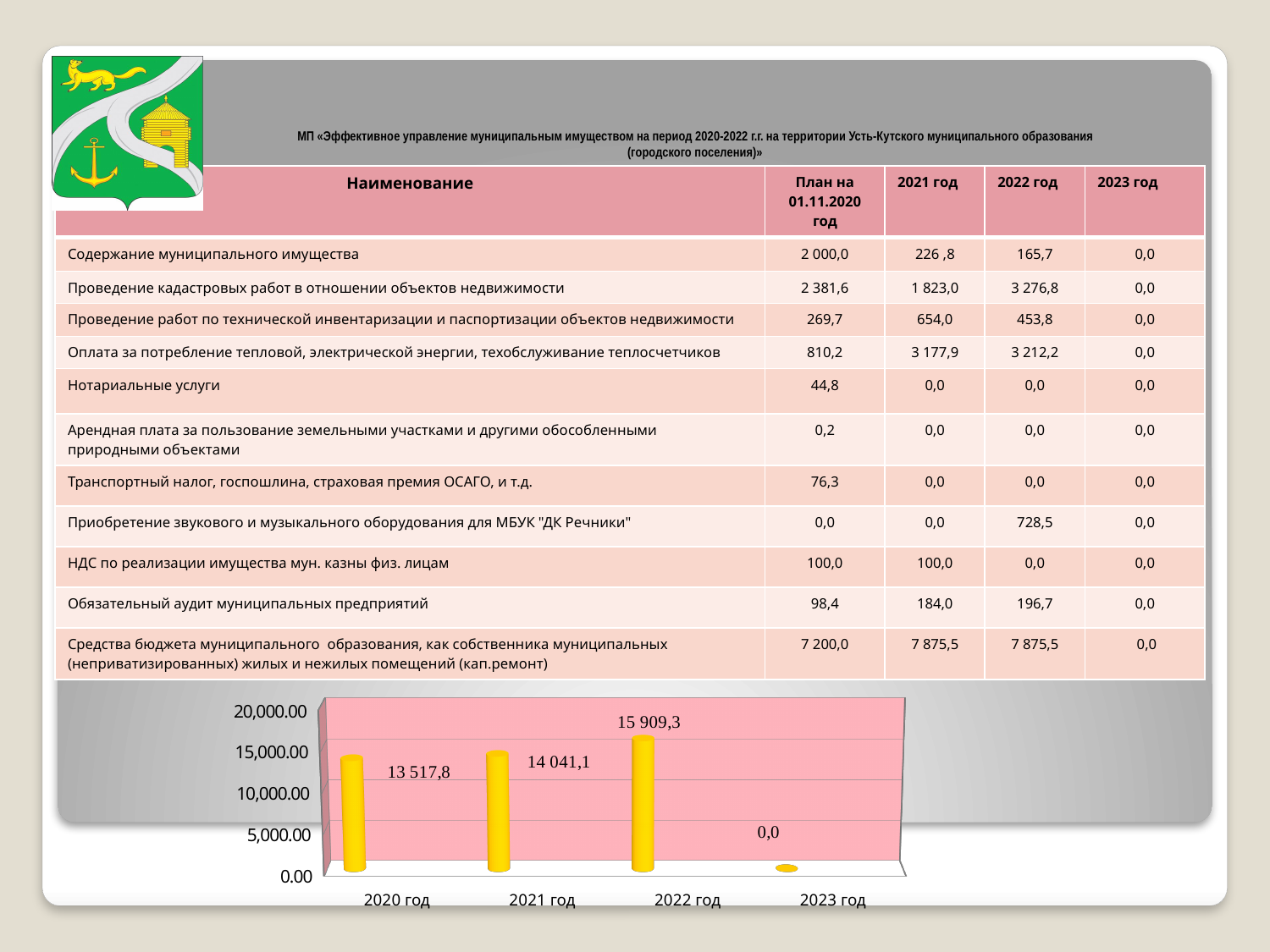
Which year has the lowest value in the chart? 2023 год What is the difference between the values for 2021 год and 2020 год in the chart? 523,3 Is the value for 2022 год in the chart greater or less than 15,000.00? greater What is the value for 2021 год in the chart? 14 041,1 What is the value for 2022 год in the chart? 15 909,3 How many categories are shown on the x axis of the chart? 4 What is the difference between the values for 2022 год and 2021 год in the chart? 1 868,2 Which year has the highest value in the chart? 2022 год What is the value for 2020 год in the chart? 13 517,8 What type of chart is shown at the bottom of the slide? bar chart Which is larger in the chart, the value for 2020 год or 2022 год? 2022 год What is the value for 2023 год in the chart? 0,0